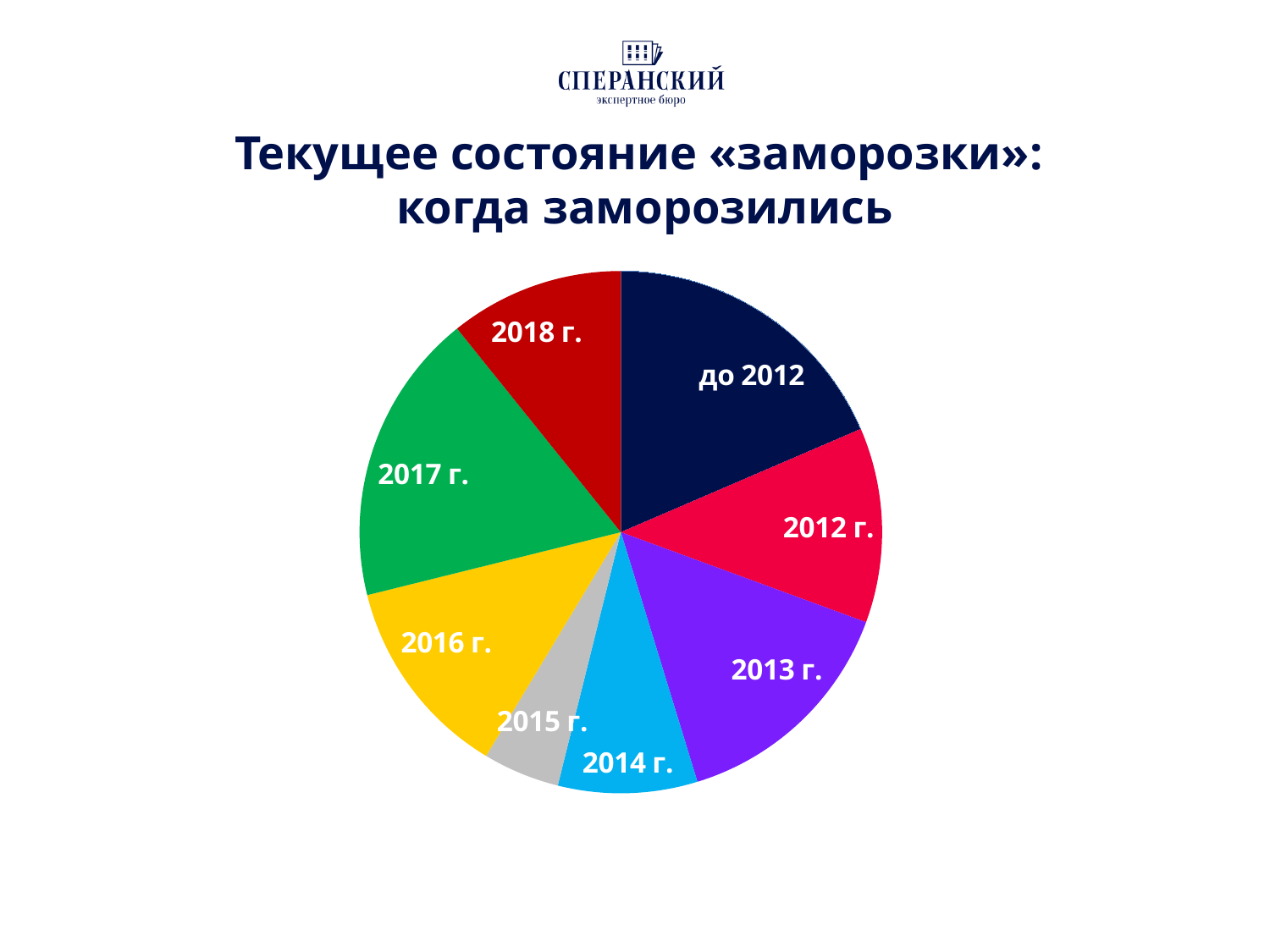
Which slice is larger, 2012 г. or 2015 г.? 2012 г. How many slices does the pie chart have? 8 Which slice is larger, 2013 г. or 2018 г.? 2013 г. Which slice is larger, 2013 г. or 2014 г.? 2013 г. What is the title of the chart on the slide? Текущее состояние «заморозки»: когда заморозились What colour is the slice labelled 2017 г.? green Which slice of the pie chart is the smallest? 2015 г. What kind of chart is shown on the slide? pie chart